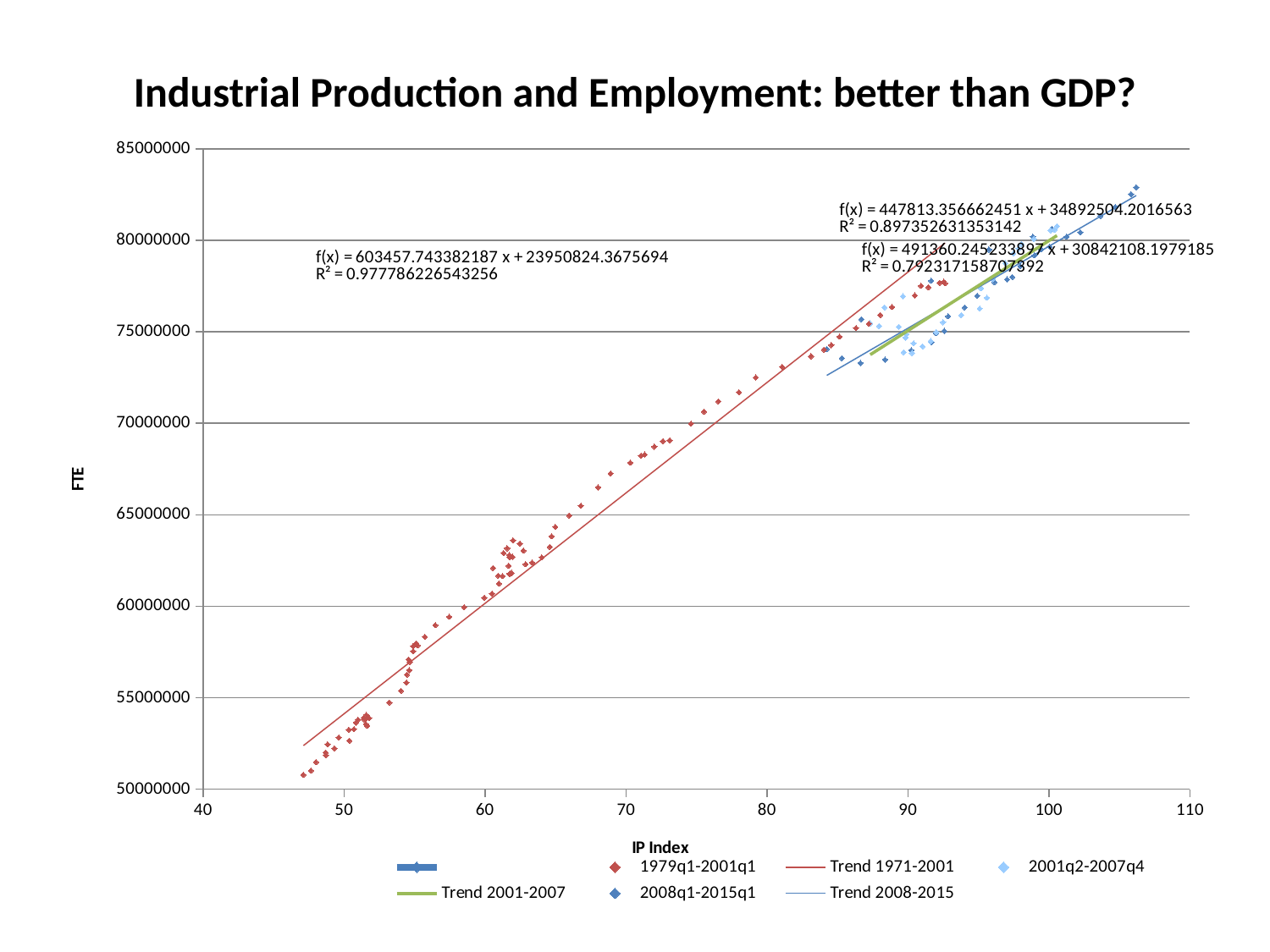
What is the slope in the trend equation whose R² is 0.977786226543256? 603457.743382187 Do the FTE values generally rise or fall as the IP Index increases along the x axis? rise What kind of chart is shown on the slide? scatter chart Is the highest plotted FTE value greater or less than 80000000? greater What is the label on the vertical axis of the chart? FTE Is the lowest plotted FTE value greater or less than 55000000? less What is the intercept in the trend equation whose R² is 0.897352631353142? 34892504.2016563 Which data series contains the points with the lowest FTE values? 1979q1-2001q1 What is the title of the chart? Industrial Production and Employment: better than GDP? Which data series contains the points with the highest FTE values? 2008q1-2015q1 What is the highest R² value printed on the chart? 0.977786226543256 What is the lowest R² value printed on the chart? 0.792317158707392